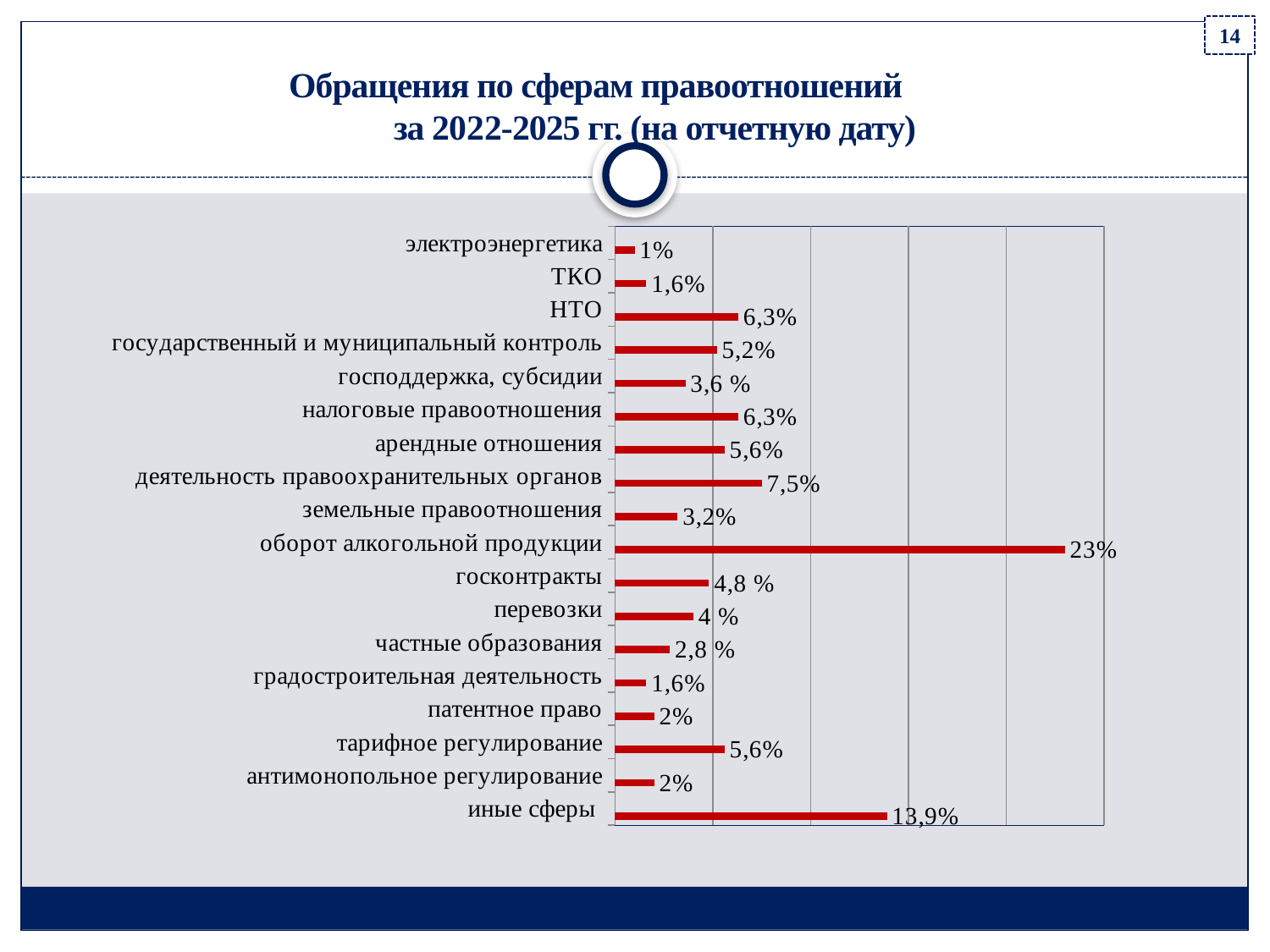
What is the title shown above the chart? Обращения по сферам правоотношений за 2022-2025 гг. (на отчетную дату) Which category has the highest value? оборот алкогольной продукции How many categories are plotted in the chart? 18 Which category has the lowest value? электроэнергетика Which is larger: the value for "деятельность правоохранительных органов" or for "арендные отношения"? деятельность правоохранительных органов What is the value for "господдержка, субсидии"? 3,6 % What is the value for "деятельность правоохранительных органов"? 7,5% What is the value for "оборот алкогольной продукции"? 23% What is the difference between the values for "оборот алкогольной продукции" and "иные сферы"? 9,1% What is the value for "иные сферы"? 13,9% What type of chart is shown on the slide? bar chart What is the value for "градостроительная деятельность"? 1,6%